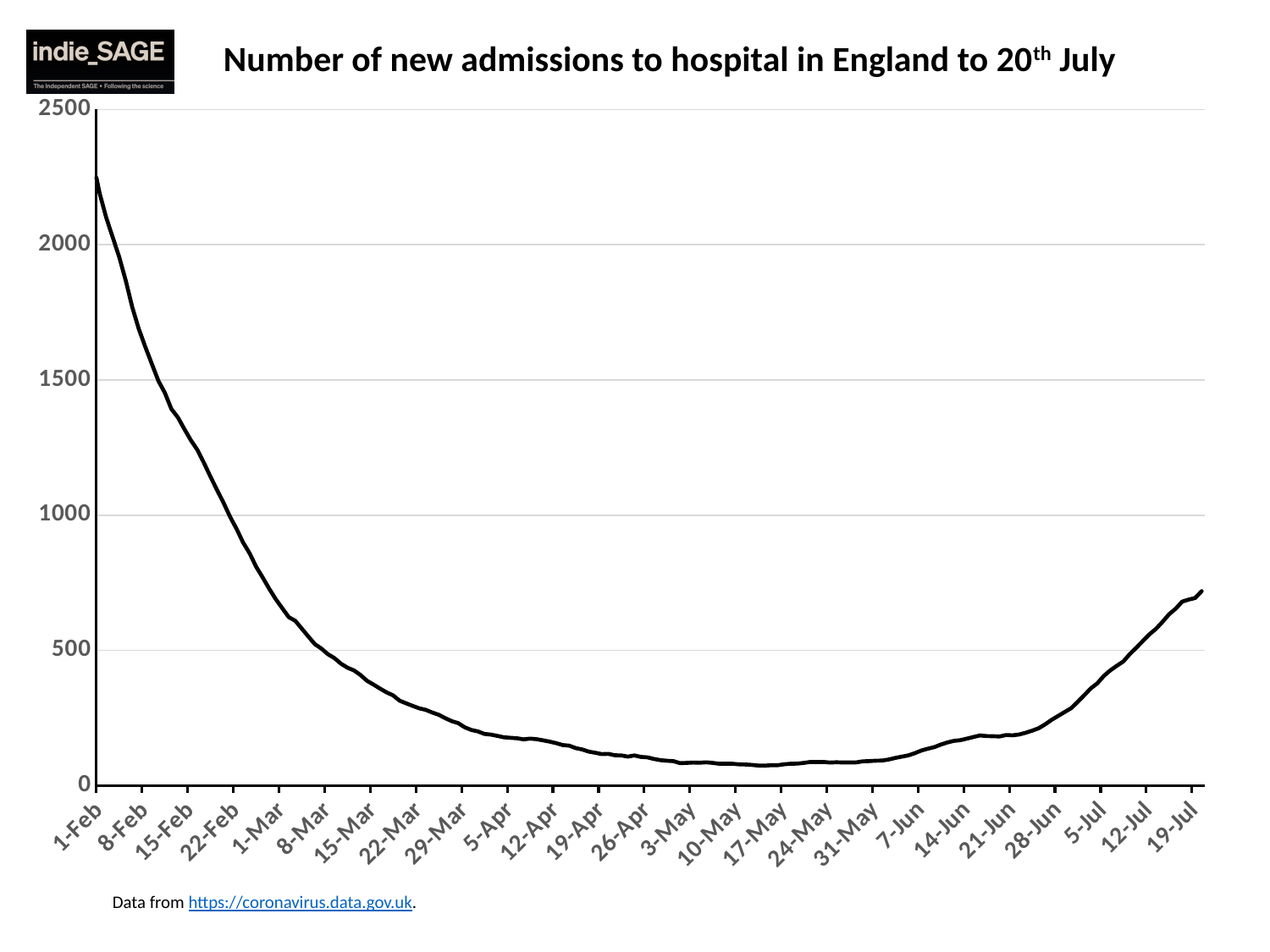
On which date label does the line reach its highest value? 1-Feb Which is larger, the value for 1-Feb or the value for 19-Jul? 1-Feb Do the values rise or fall between 1-Feb and 1-Mar? fall Is the value for 15-Feb greater or less than 1000? greater What is the title of the chart? Number of new admissions to hospital in England to 20th July Is the value for 19-Jul greater or less than 500? greater What kind of chart is shown on the slide? line chart Do the values rise or fall between 28-Jun and 19-Jul? rise Is the value for 1-Feb greater or less than 2000? greater